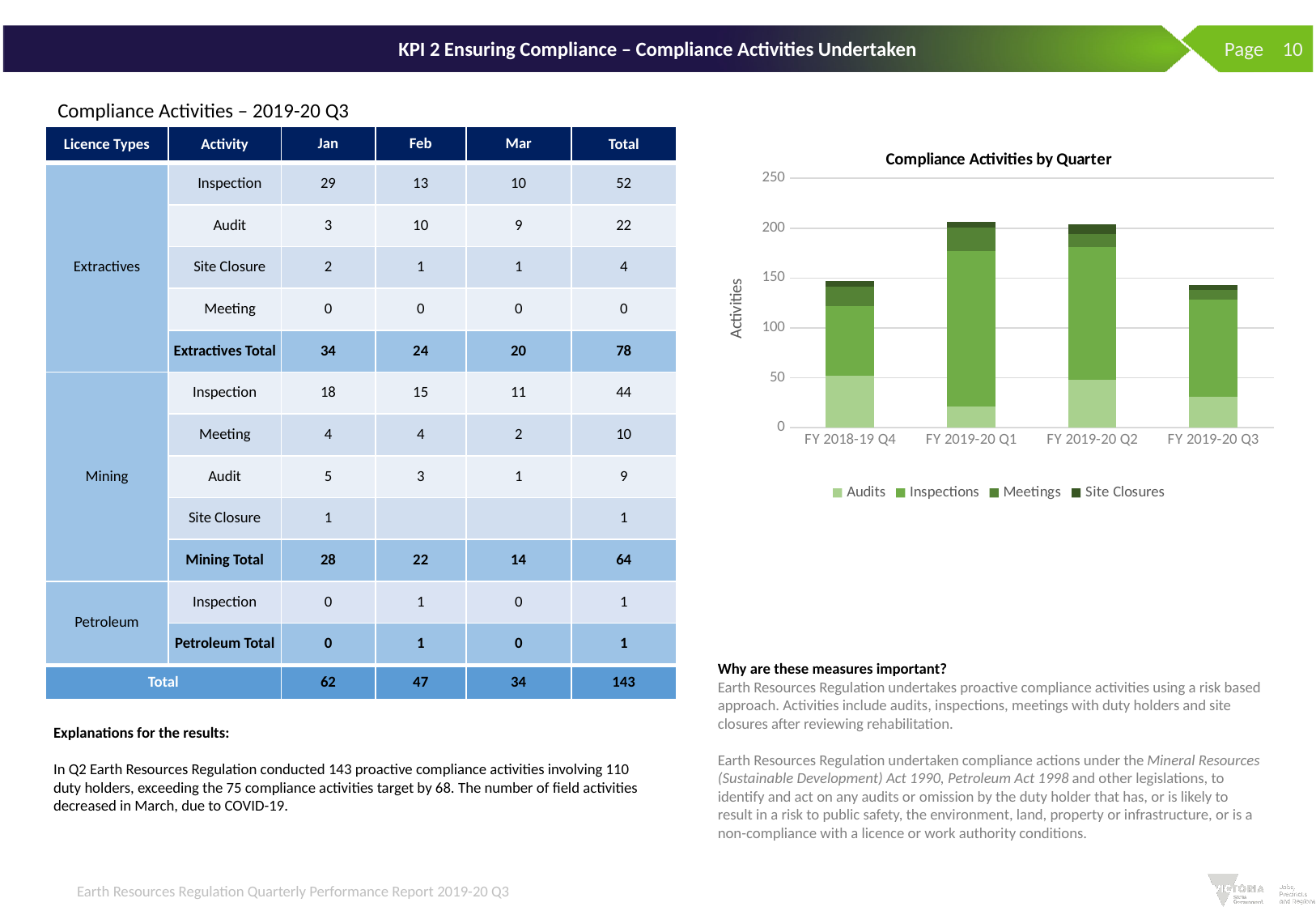
Is the Audits segment for FY 2019-20 Q1 greater or less than 50? less What is the label on the y axis of the chart? Activities How many quarters are plotted on the x axis of the chart? 4 Is the total bar height for FY 2019-20 Q1 greater or less than 200? greater Is the total bar height for FY 2018-19 Q4 greater or less than 200? less Which bar is taller, FY 2019-20 Q1 or FY 2019-20 Q3? FY 2019-20 Q1 What kind of chart is shown on the slide? stacked bar chart How many series does the chart legend list? 4 Which series makes up the largest part of each stacked bar in the chart? Inspections Which bar is taller, FY 2018-19 Q4 or FY 2019-20 Q2? FY 2019-20 Q2 What is the title of the chart? Compliance Activities by Quarter